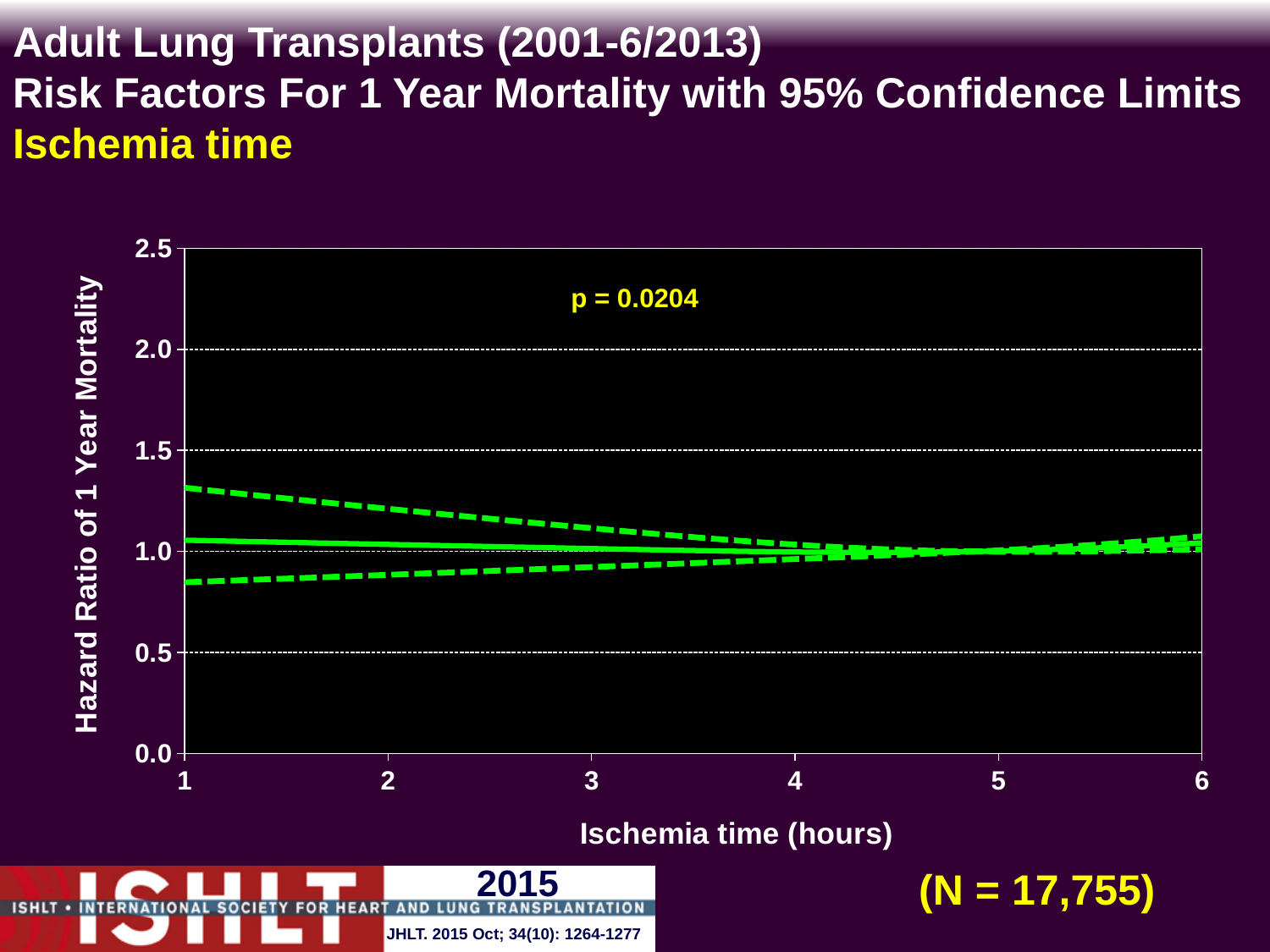
What p-value is printed on the chart? p = 0.0204 Does the upper dashed confidence limit line rise or fall as ischemia time increases from 1 to 5 hours? fall Is the upper confidence limit higher at 1 hour or at 4 hours of ischemia time? 1 hour Is the solid hazard ratio line at 2 hours of ischemia time greater or less than 0.5? greater Does the lower dashed confidence limit line rise or fall as ischemia time increases from 1 to 5 hours? rise Is the upper confidence limit at 1 hour of ischemia time greater or less than 1.0? greater Is the lower confidence limit at 1 hour of ischemia time greater or less than 1.0? less What sample size (N) is shown on the slide? N = 17,755 What kind of chart is shown on the slide? line chart Is the lower confidence limit higher at 1 hour or at 4 hours of ischemia time? 4 hours